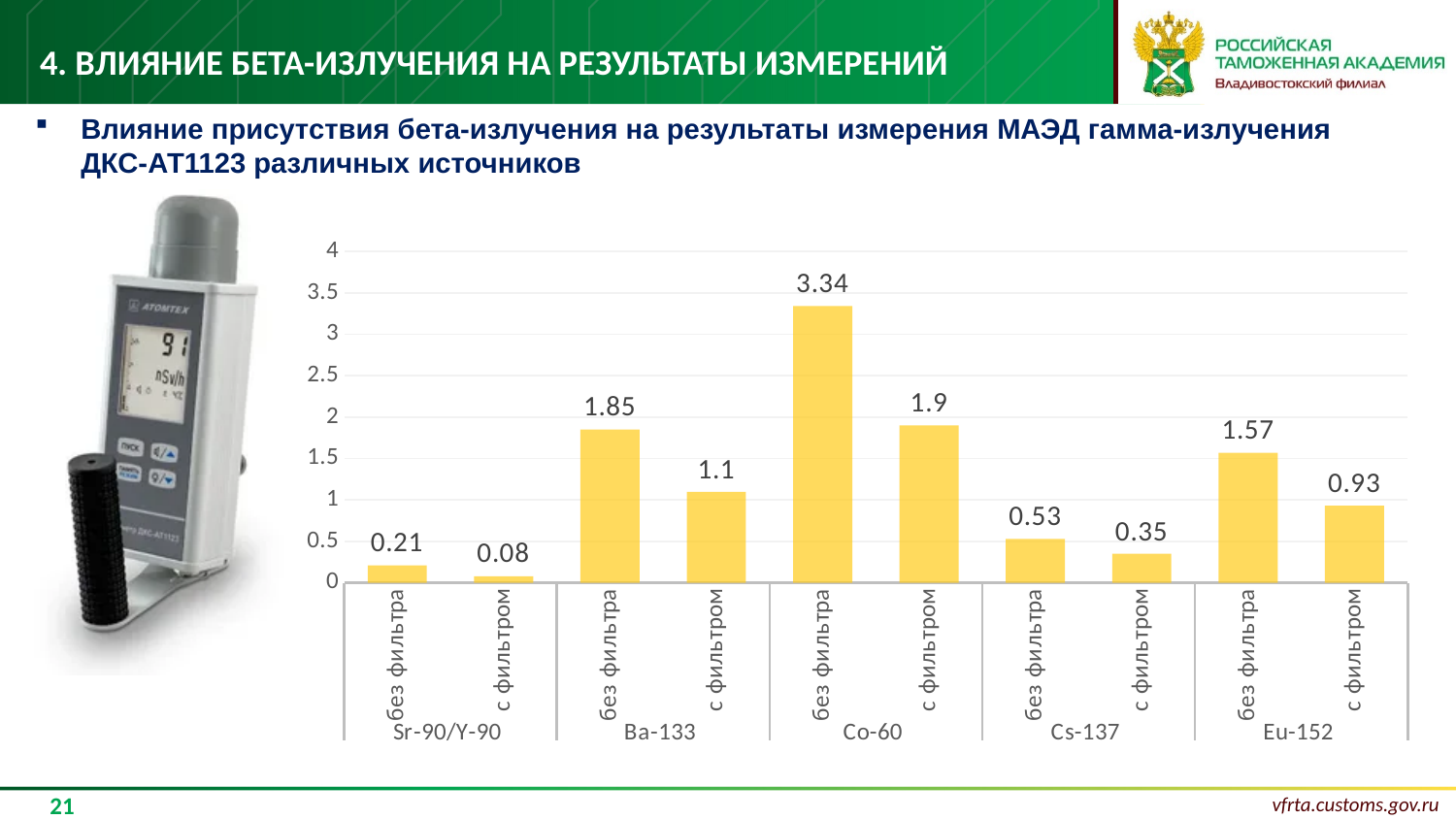
Is the value for Co-60 с фильтром greater or less than 1.5? greater Which is larger: Ba-133 без фильтра or Eu-152 без фильтра? Ba-133 без фильтра What is the difference between the без фильтра and с фильтром values for Co-60? 1.44 What is the value for Sr-90/Y-90 с фильтром? 0.08 What kind of chart is shown on the slide? bar chart Which bar has the lowest value? Sr-90/Y-90 с фильтром How many bars are plotted in the chart? 10 What is the value for Co-60 без фильтра? 3.34 What is the difference between the без фильтра and с фильтром values for Cs-137? 0.18 What is the value for Ba-133 с фильтром? 1.1 What is the value for Eu-152 без фильтра? 1.57 Which bar has the highest value? Co-60 без фильтра